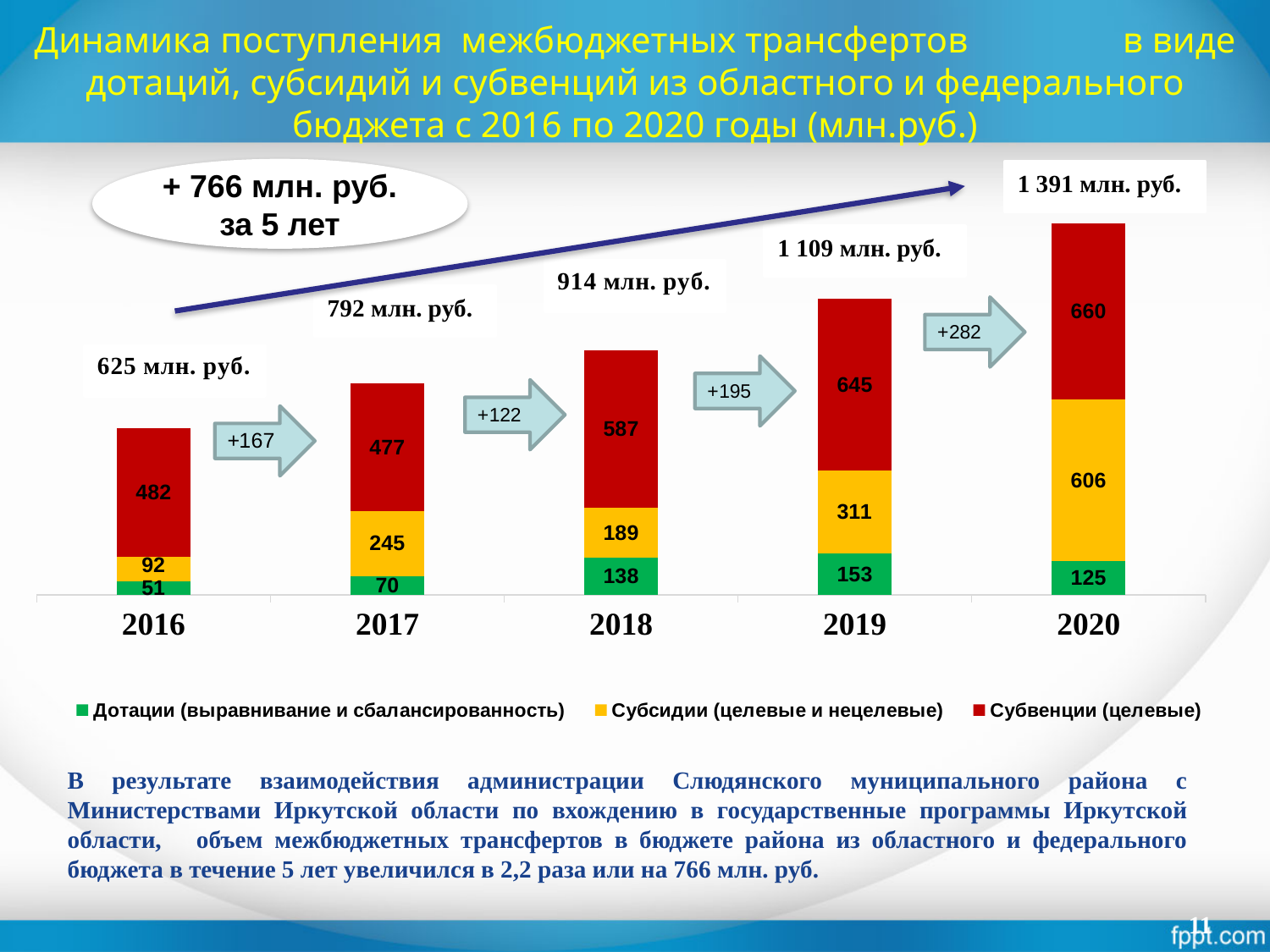
What type of chart is shown on the slide? stacked bar chart How many series does the legend list? 3 What is the total of the stacked bar for 2019, as labelled on the slide? 1 109 млн. руб. Which is larger: Субсидии (целевые и нецелевые) in 2017 or in 2018? 2017 What is the value of Субвенции (целевые) for 2018? 587 What is the value of Субсидии (целевые и нецелевые) for 2020? 606 What is the value of Дотации (выравнивание и сбалансированность) for 2016? 51 In which year is the Субсидии (целевые и нецелевые) value the highest? 2020 In which year is the Дотации (выравнивание и сбалансированность) value the lowest? 2016 Do the total values of the stacked bars rise or fall from 2016 to 2020? rise How many years (categories) are shown on the x axis? 5 What is the difference between the Субвенции (целевые) values for 2020 and 2019? 15